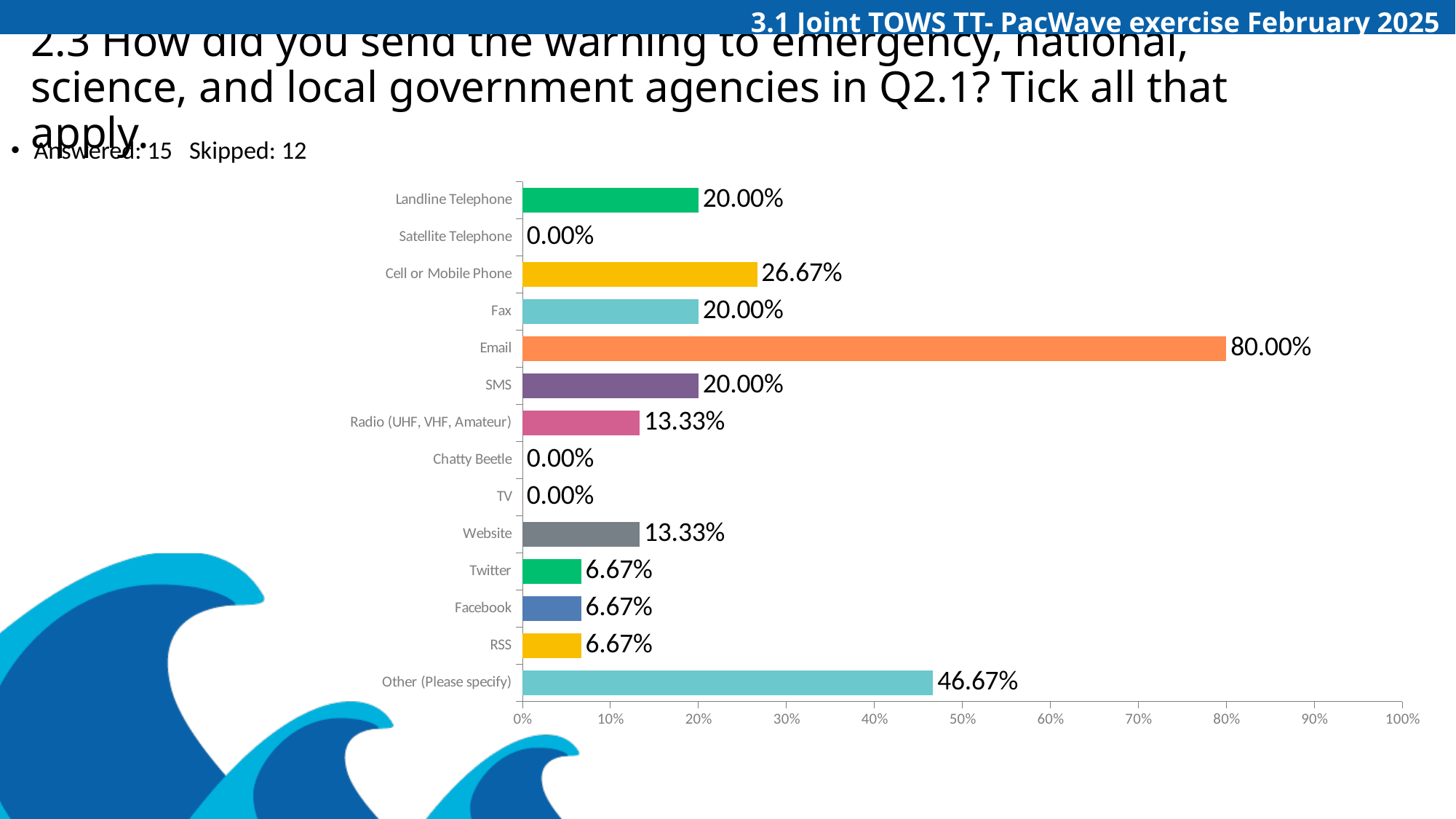
How many categories are shown on the chart? 14 What is the difference between the values for Cell or Mobile Phone and Fax? 6.67% Which is larger, the value for Website or the value for Twitter? Website What is the value for Email? 80.00% What is the value for Radio (UHF, VHF, Amateur)? 13.33% Is the value for Other (Please specify) greater or less than 40%? greater Which category has the highest value? Email What is the value for Other (Please specify)? 46.67% How many categories have a value of 0.00%? 3 What is the difference between the values for Email and Other (Please specify)? 33.33% What is the value for Cell or Mobile Phone? 26.67% What kind of chart is shown on the slide? bar chart